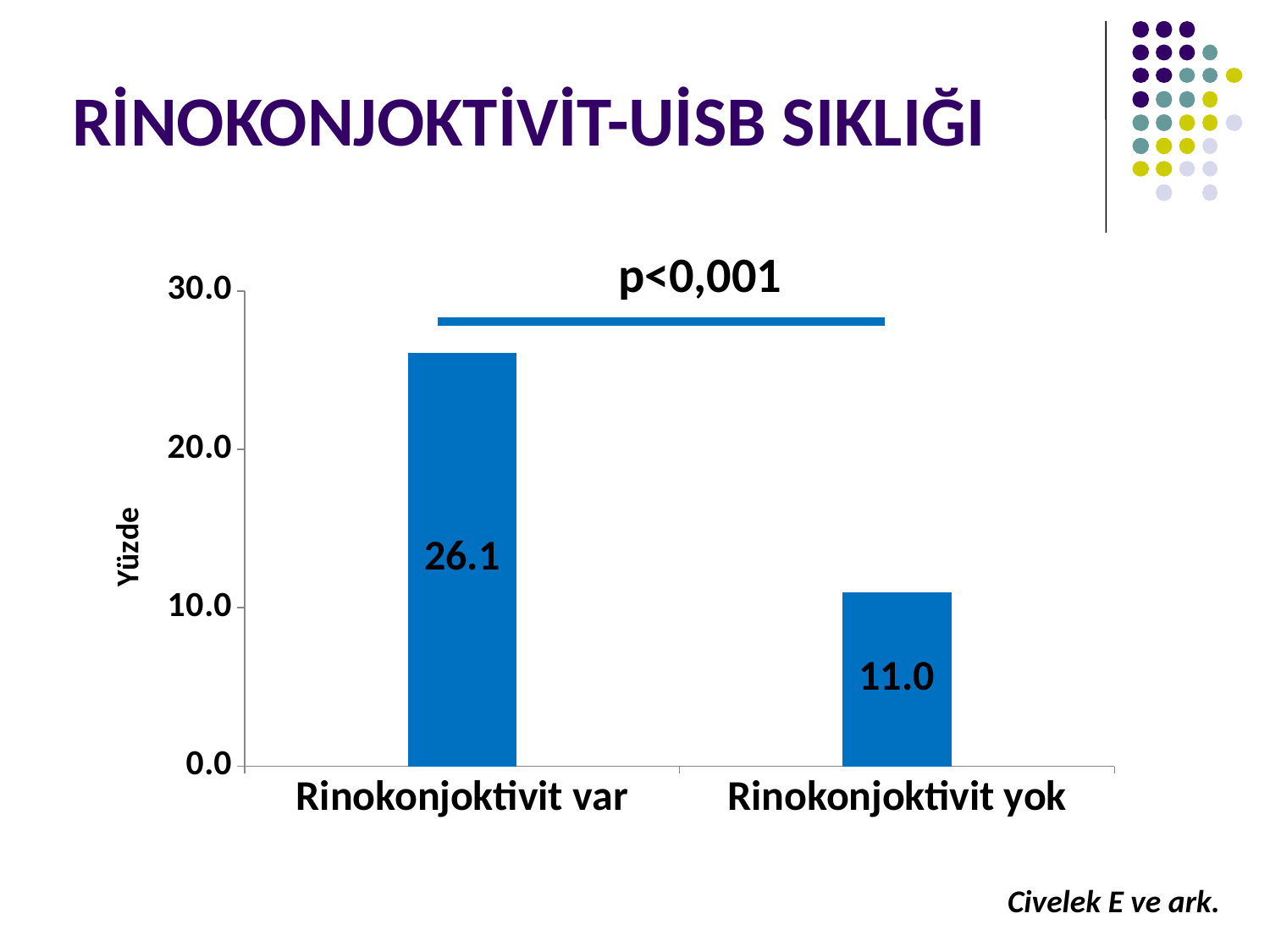
What is the value for Rinokonjoktivit var? 26.1 What is the value for Rinokonjoktivit yok? 11.0 Which category has the highest value? Rinokonjoktivit var What p-value is shown above the bars? p<0,001 Is the value for Rinokonjoktivit var greater or less than 20.0? greater What is the label of the vertical axis? Yüzde What is the difference between the values for Rinokonjoktivit var and Rinokonjoktivit yok? 15.1 Is the value for Rinokonjoktivit yok greater or less than 20.0? less What kind of chart is shown on the slide? bar chart How many categories are shown on the chart? 2 Which category has the lowest value? Rinokonjoktivit yok Which is larger, the value for Rinokonjoktivit var or Rinokonjoktivit yok? Rinokonjoktivit var